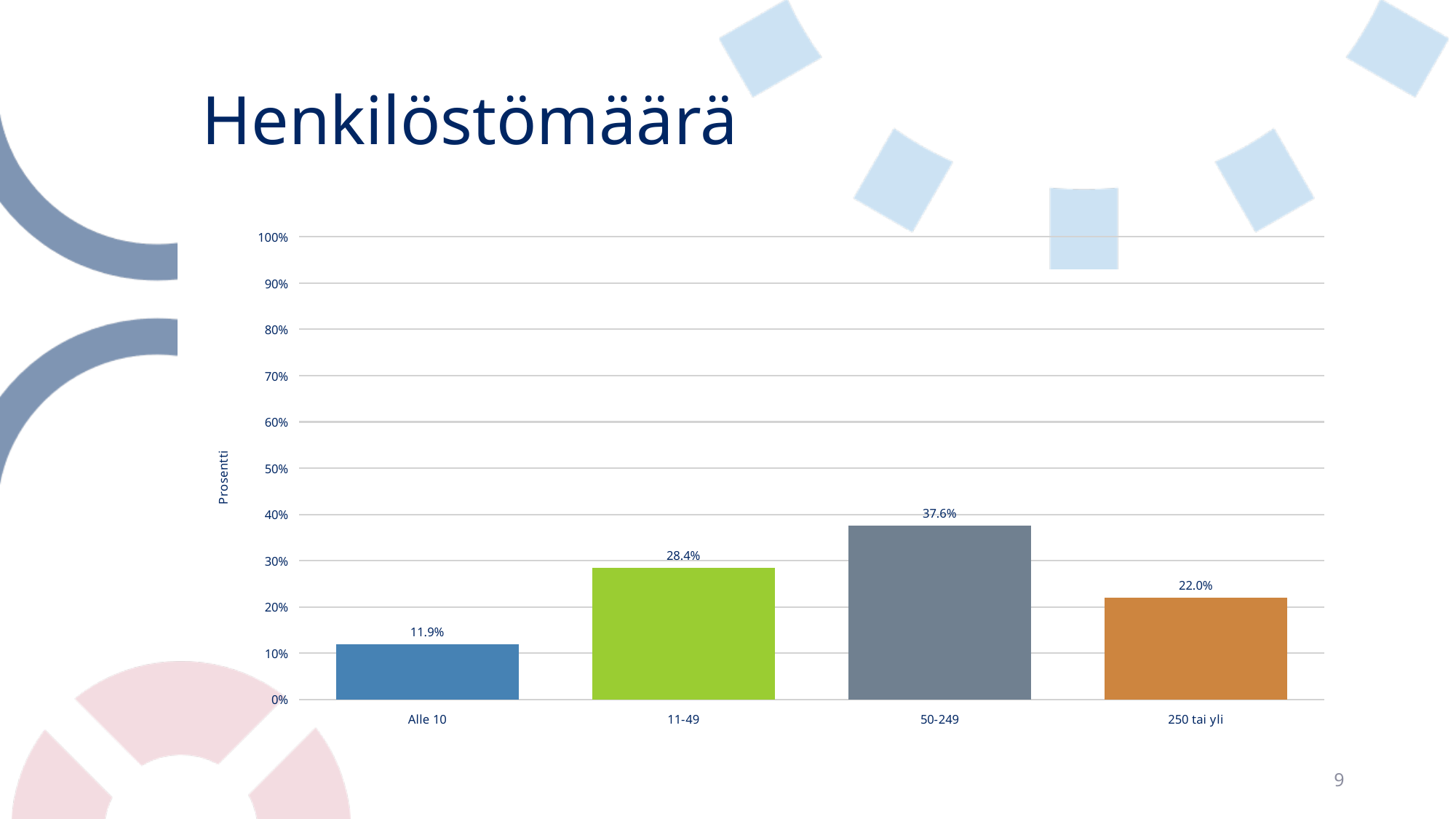
Which category has the lowest value? Alle 10 How many categories are shown on the x axis? 4 What is the value for the "50-249" category? 37.6% What is the value for the "11-49" category? 28.4% What is the value for the "Alle 10" category? 11.9% What is the title of the slide containing the chart? Henkilöstömäärä Which category has the highest value? 50-249 What is the difference between the values for "50-249" and "11-49"? 9.2% What kind of chart is shown on the slide? bar chart What is the value for the "250 tai yli" category? 22.0% Which is larger, the value for "250 tai yli" or the value for "11-49"? 11-49 Is the value for "50-249" greater or less than 40%? less